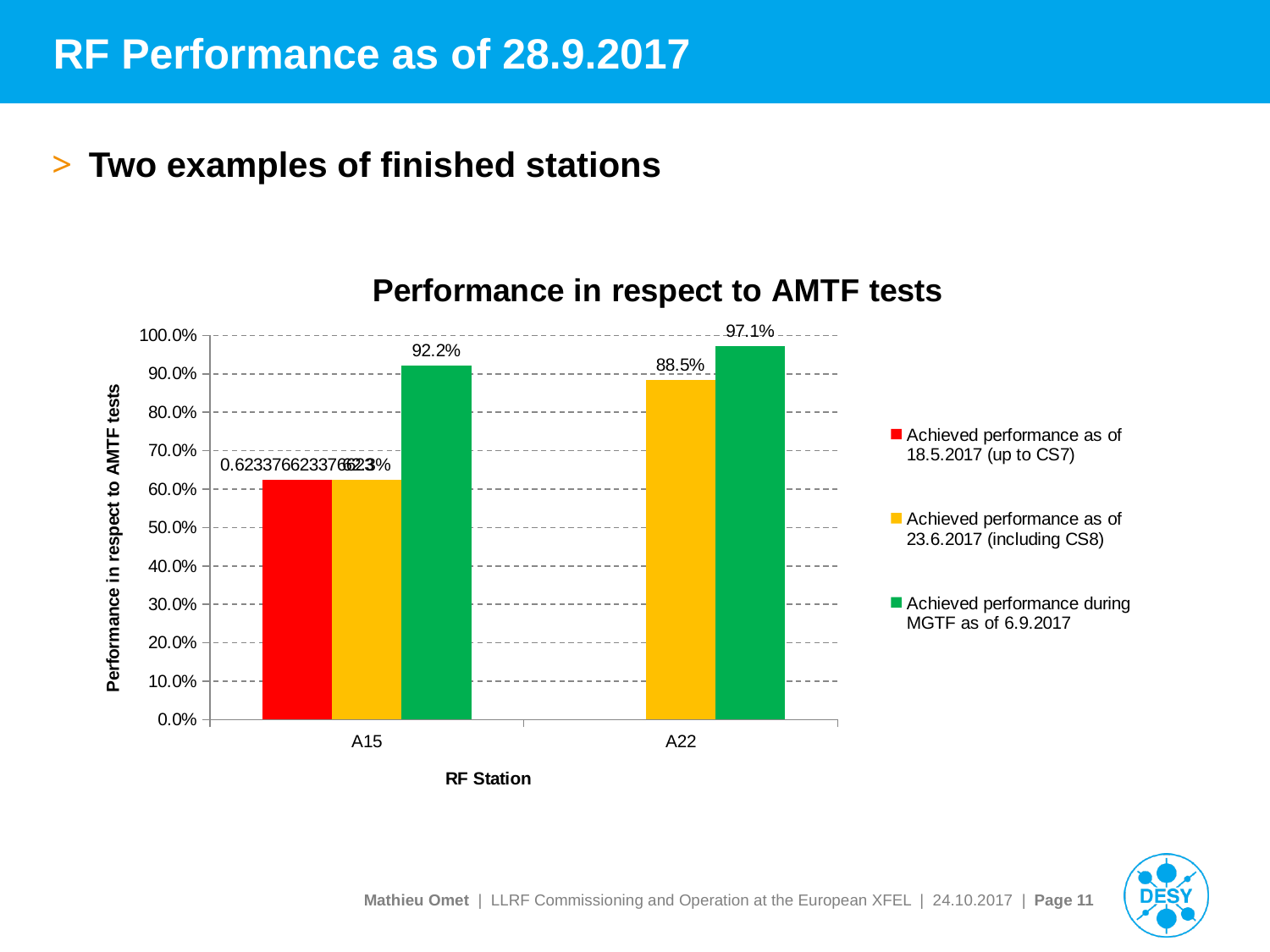
What is the achieved performance as of 23.6.2017 (including CS8) for RF station A22? 88.5% How many RF stations are shown on the x axis? 2 Is the achieved performance as of 18.5.2017 (up to CS7) for A15 greater or less than 70%? less What is the achieved performance during MGTF as of 6.9.2017 for RF station A22? 97.1% What kind of chart is shown on the slide? bar chart By how many percentage points does the MGTF performance of A22 exceed that of A15? 4.9 percentage points What is the achieved performance during MGTF as of 6.9.2017 for RF station A15? 92.2% What is the title of the x axis? RF Station Which RF station has the higher achieved performance during MGTF as of 6.9.2017, A15 or A22? A22 For RF station A22, what is the difference between the MGTF performance as of 6.9.2017 and the performance as of 23.6.2017? 8.6 percentage points How many series does the legend list? 3 Which bar in the chart has the highest value? A22, achieved performance during MGTF as of 6.9.2017 (97.1%)